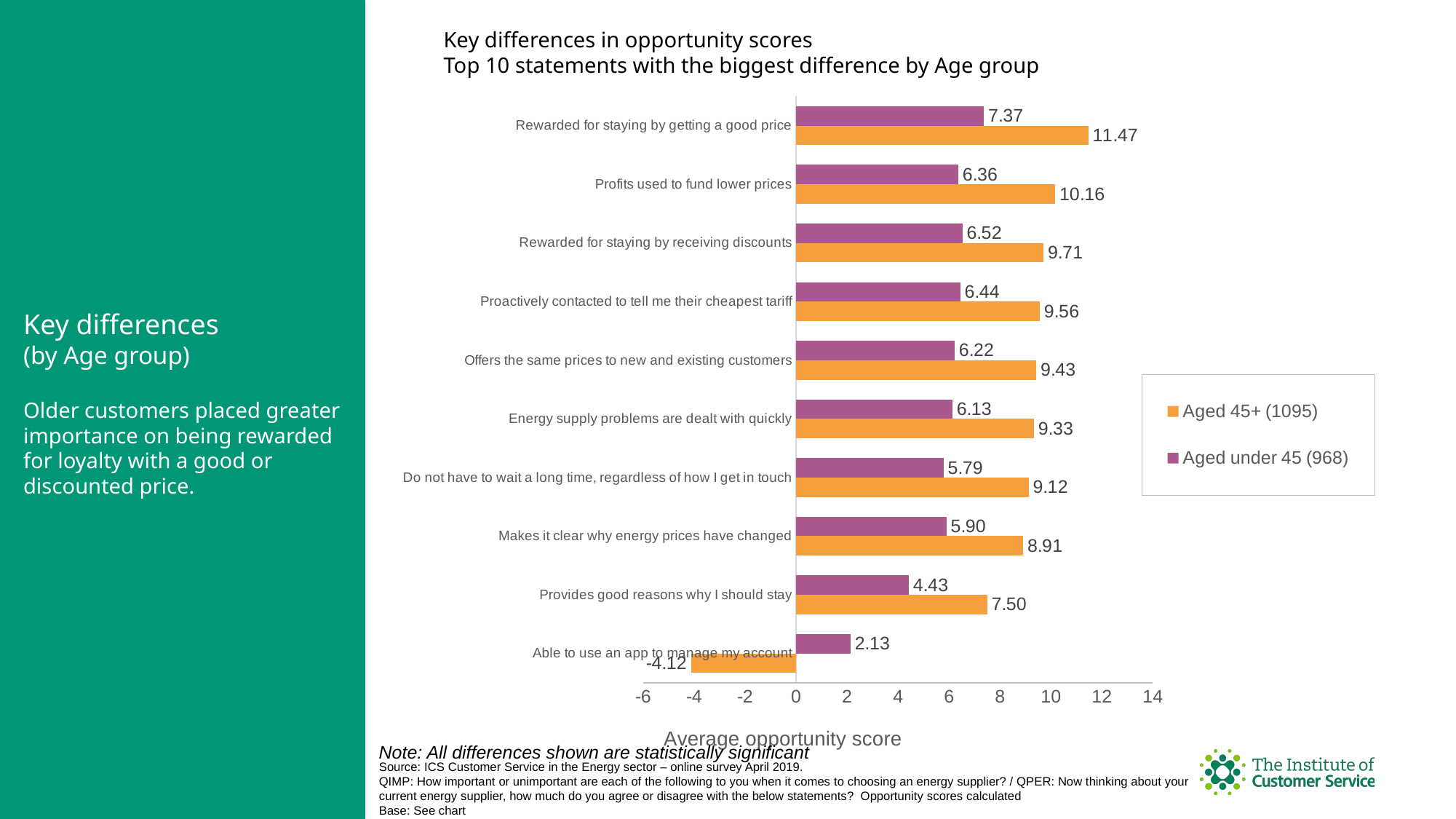
What is the average opportunity score for 'Rewarded for staying by getting a good price' among those aged 45+? 11.47 What is the average opportunity score for 'Able to use an app to manage my account' among those aged under 45? 2.13 Which statement has the lowest average opportunity score for the Aged 45+ group? Able to use an app to manage my account What type of chart is shown on the slide? Bar chart What is the difference between the Aged 45+ and Aged under 45 scores for 'Rewarded for staying by getting a good price'? 4.10 For 'Able to use an app to manage my account', which age group has the higher average opportunity score? Aged under 45 Is the Aged 45+ score for 'Makes it clear why energy prices have changed' greater or less than 10? less How many series does the legend list? 2 What is the average opportunity score for 'Profits used to fund lower prices' among those aged under 45? 6.36 What is the difference between the Aged 45+ and Aged under 45 scores for 'Provides good reasons why I should stay'? 3.07 How many statements are shown in the chart? 10 Which statement has the highest average opportunity score for the Aged 45+ group? Rewarded for staying by getting a good price